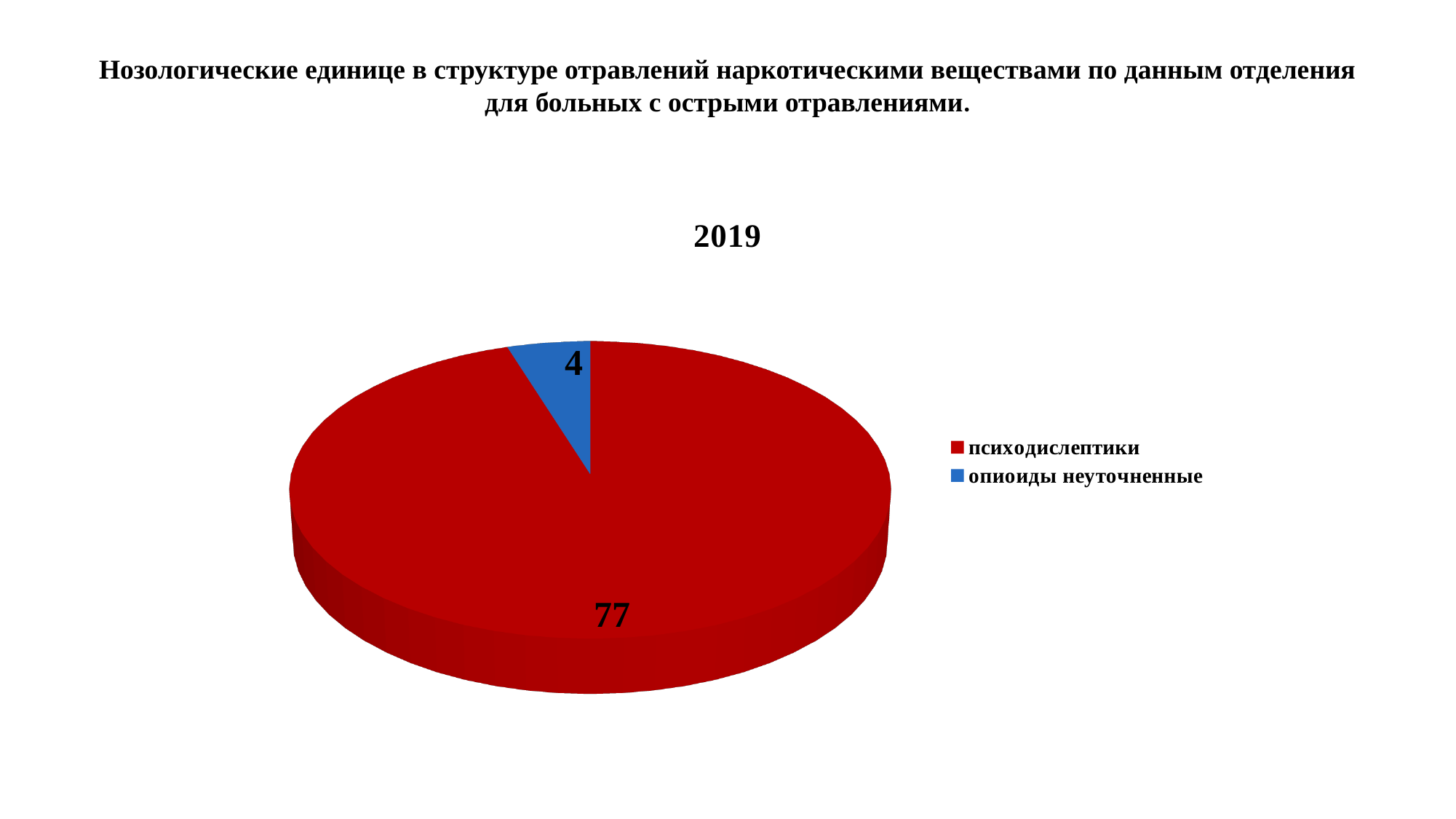
What is the total of all slices in the pie chart? 81 What kind of chart is shown on the slide? pie chart Which category has the largest slice? психодислептики Which is larger, the value for психодислептики or for опиоиды неуточненные? психодислептики What colour is the slice for опиоиды неуточненные? blue What is the difference between the values for психодислептики and опиоиды неуточненные? 73 What is the chart title shown above the pie? 2019 Which category has the smallest slice? опиоиды неуточненные What is the value for психодислептики? 77 What is the value for опиоиды неуточненные? 4 How many categories does the pie chart have? 2